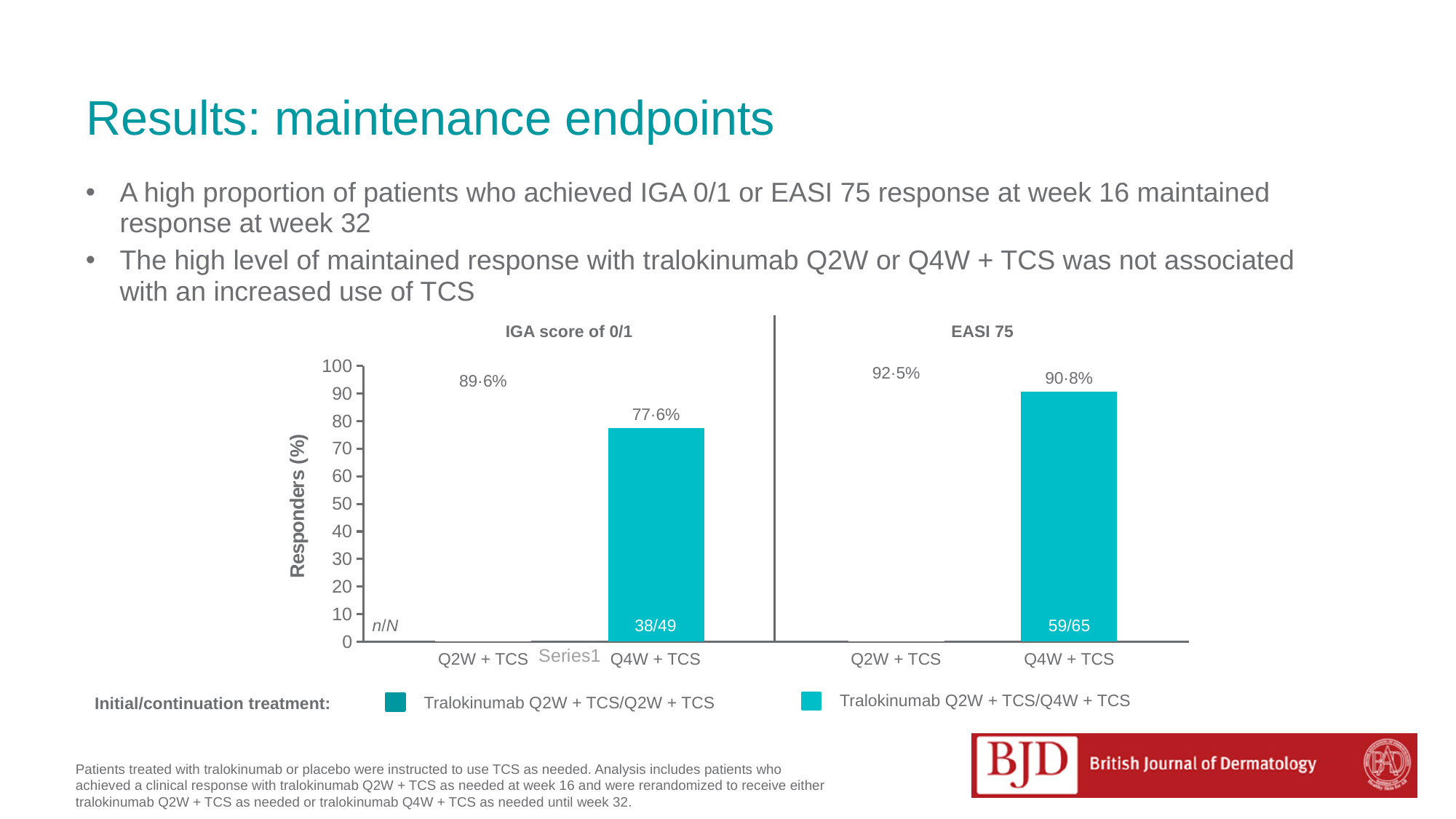
What n/N value is printed on the Q4W + TCS bar in the IGA score of 0/1 panel? 38/49 In the IGA score of 0/1 panel, what percentage of responders is shown for Q2W + TCS? 89·6% Is the Q4W + TCS responder percentage in the EASI 75 panel greater or less than 80? greater In the EASI 75 panel, what percentage of responders is shown for Q2W + TCS? 92·5% What is the label of the y axis of the chart? Responders (%) In the IGA score of 0/1 panel, what is the difference in responder percentage between Q2W + TCS and Q4W + TCS? 12·0% In the EASI 75 panel, what percentage of responders is shown for Q4W + TCS? 90·8% What kind of chart is used to show the maintenance endpoints? Bar chart In the EASI 75 panel, what is the difference in responder percentage between Q2W + TCS and Q4W + TCS? 1·7% In the IGA score of 0/1 panel, what percentage of responders is shown for Q4W + TCS? 77·6% What n/N value is printed on the Q4W + TCS bar in the EASI 75 panel? 59/65 In the IGA score of 0/1 panel, which treatment group has the higher responder percentage, Q2W + TCS or Q4W + TCS? Q2W + TCS